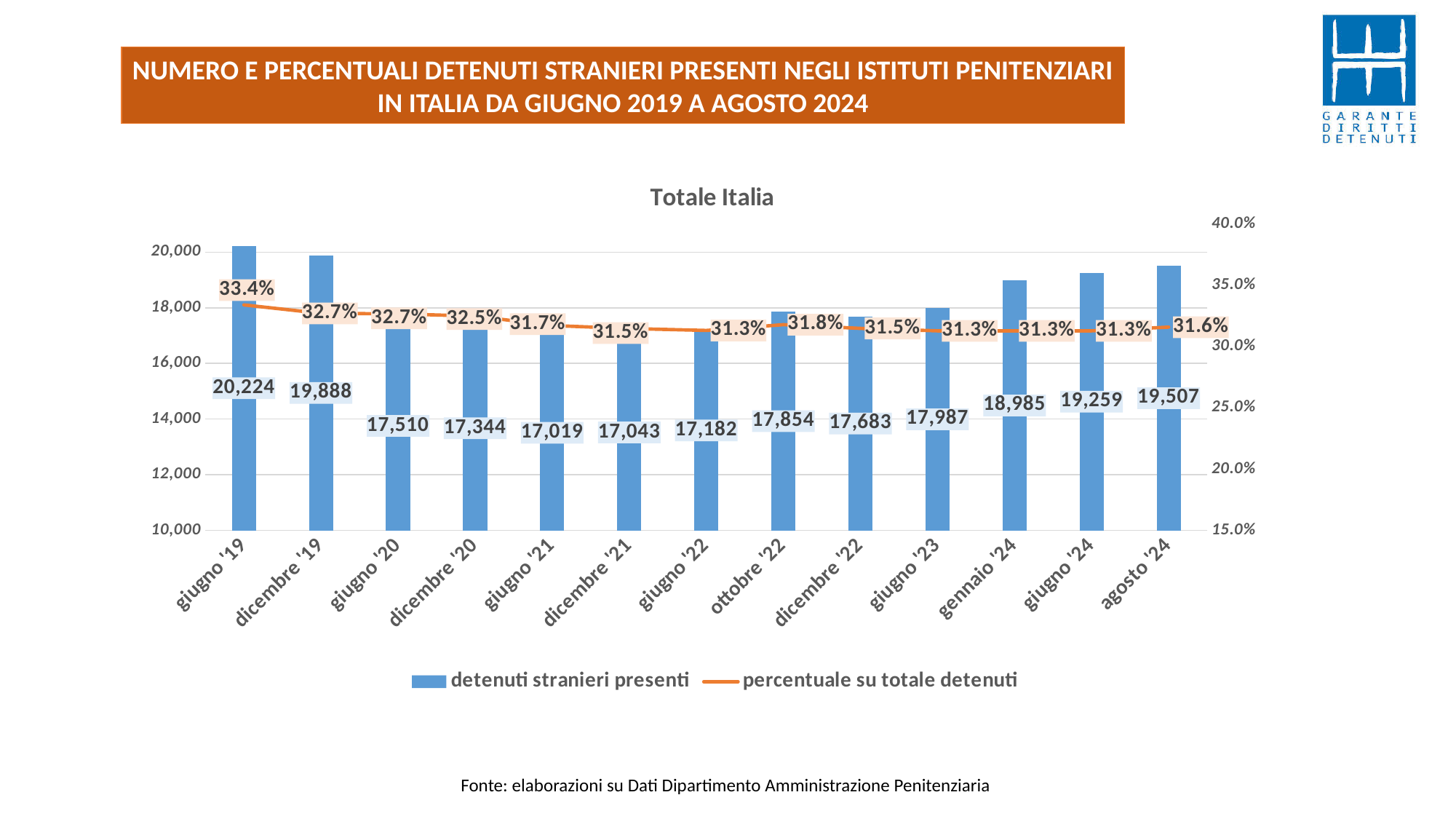
Which period has the lowest number of detenuti stranieri presenti? giugno '21 How many series does the legend list? 2 What is the number of detenuti stranieri presenti for agosto '24? 19,507 What is the title of the chart? Totale Italia How many periods are shown on the x axis? 13 Is the number of detenuti stranieri presenti for gennaio '24 greater or less than 18,000? greater Which period has the highest number of detenuti stranieri presenti? giugno '19 What is the difference in detenuti stranieri presenti between giugno '19 and dicembre '19? 336 Which is larger, the number of detenuti stranieri presenti in ottobre '22 or in dicembre '22? ottobre '22 What is the percentuale su totale detenuti for dicembre '21? 31.5% What is the number of detenuti stranieri presenti for giugno '19? 20,224 What is the highest percentuale su totale detenuti shown? 33.4%